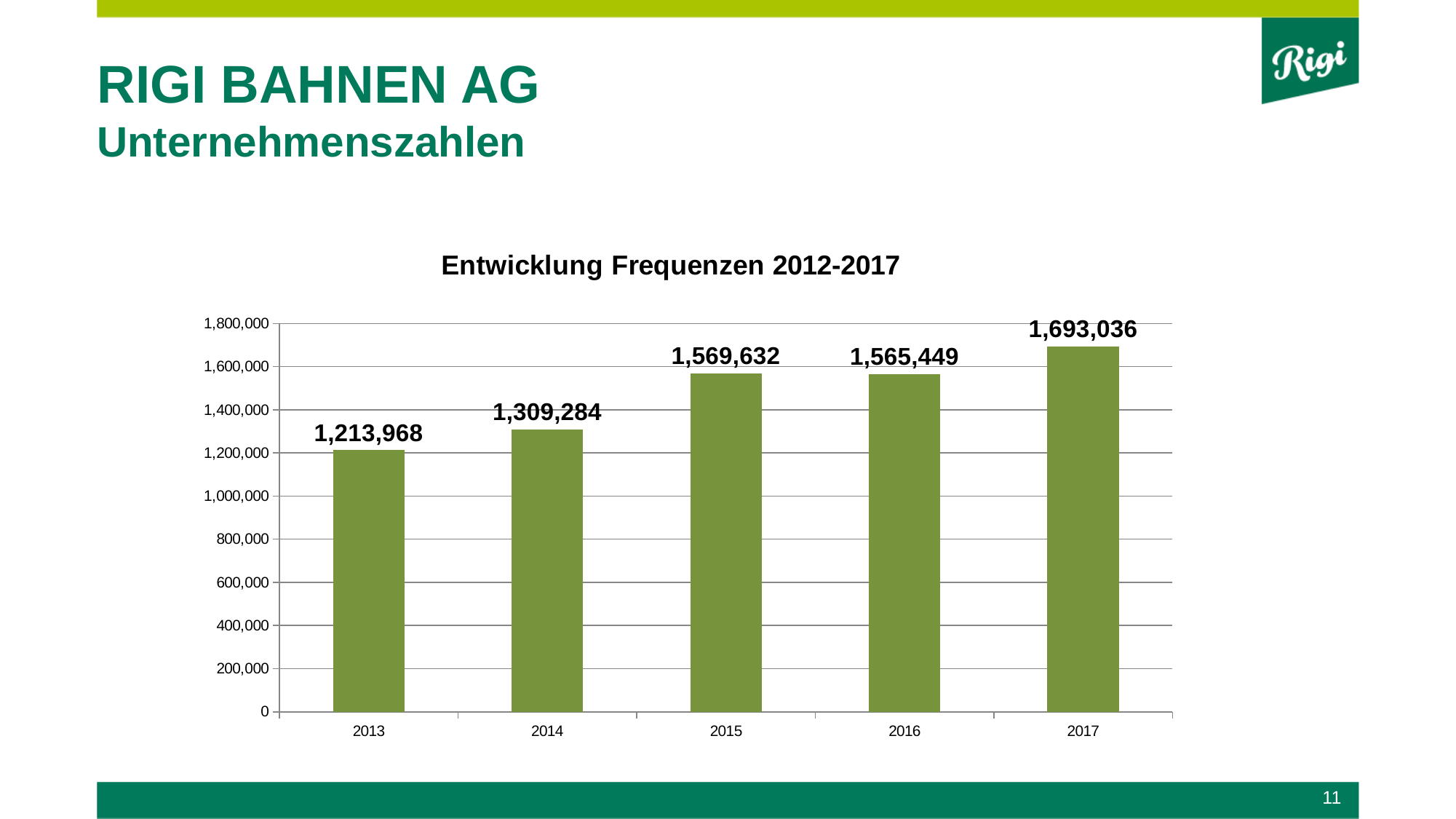
What is the value for 2015? 1,569,632 Which is larger, the value for 2015 or the value for 2016? 2015 How many years are shown on the x axis? 5 Which year has the highest value? 2017 What is the difference between the values for 2014 and 2013? 95,316 What is the title of the chart? Entwicklung Frequenzen 2012-2017 Is the value for 2014 greater or less than 1,400,000? less What kind of chart is this? bar chart What is the value for 2017? 1,693,036 Which year has the lowest value? 2013 What is the difference between the values for 2017 and 2016? 127,587 What is the value for 2013? 1,213,968